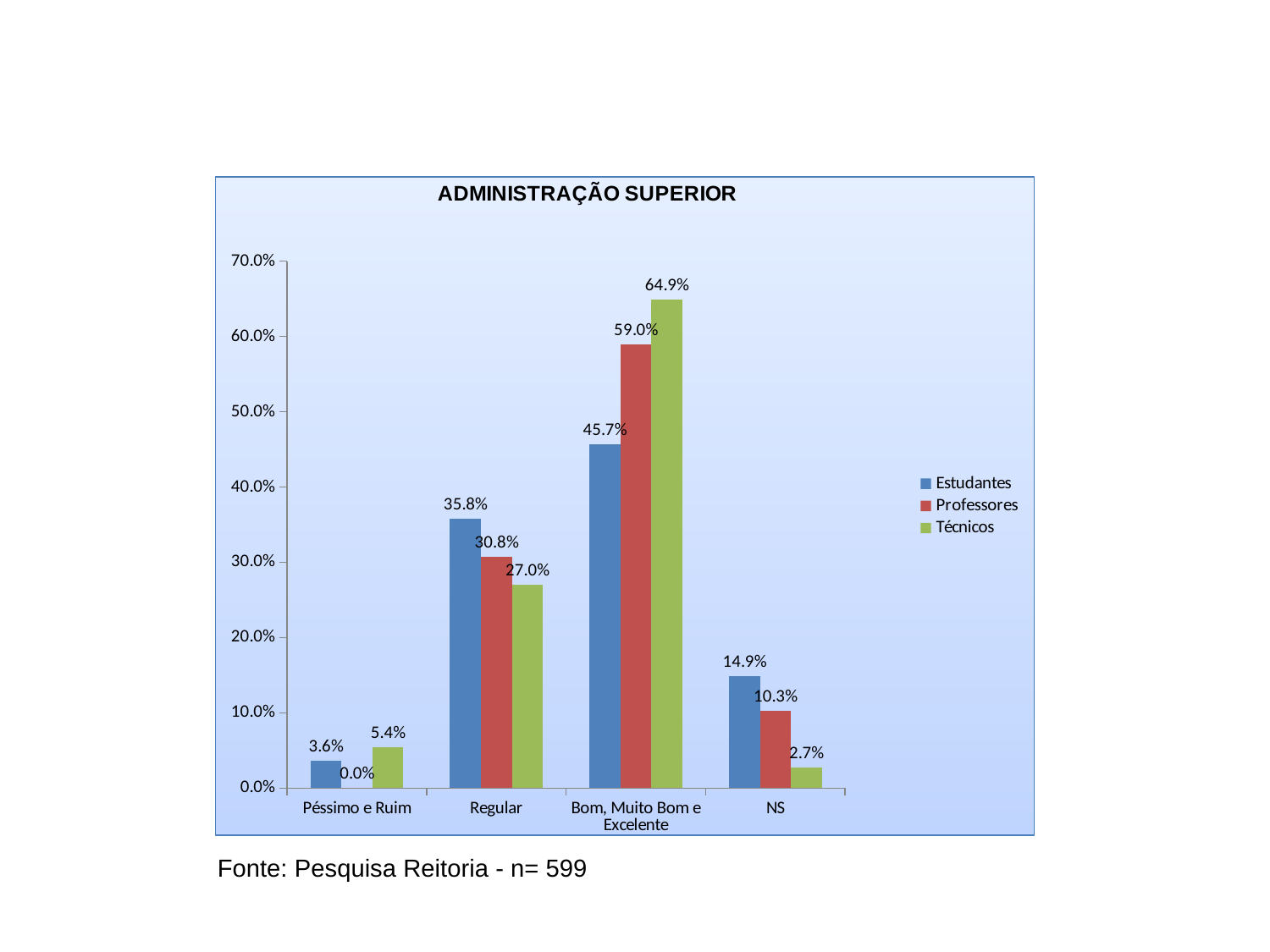
What is the difference between the Técnicos and Estudantes values in the 'Bom, Muito Bom e Excelente' category? 19.2% What is the value for Estudantes in the 'Regular' category? 35.8% Which category has the highest value for Estudantes? Bom, Muito Bom e Excelente What is the value for Professores in the 'Péssimo e Ruim' category? 0.0% How many categories are shown on the x axis? 4 What is the title of the chart? ADMINISTRAÇÃO SUPERIOR How many series does the legend list? 3 Which is larger in the 'Regular' category, the value for Professores or the value for Técnicos? Professores What kind of chart is shown on the slide? Bar chart What is the value for Técnicos in the 'Bom, Muito Bom e Excelente' category? 64.9% Which category has the lowest value for Técnicos? NS What is the value for Professores in the 'NS' category? 10.3%